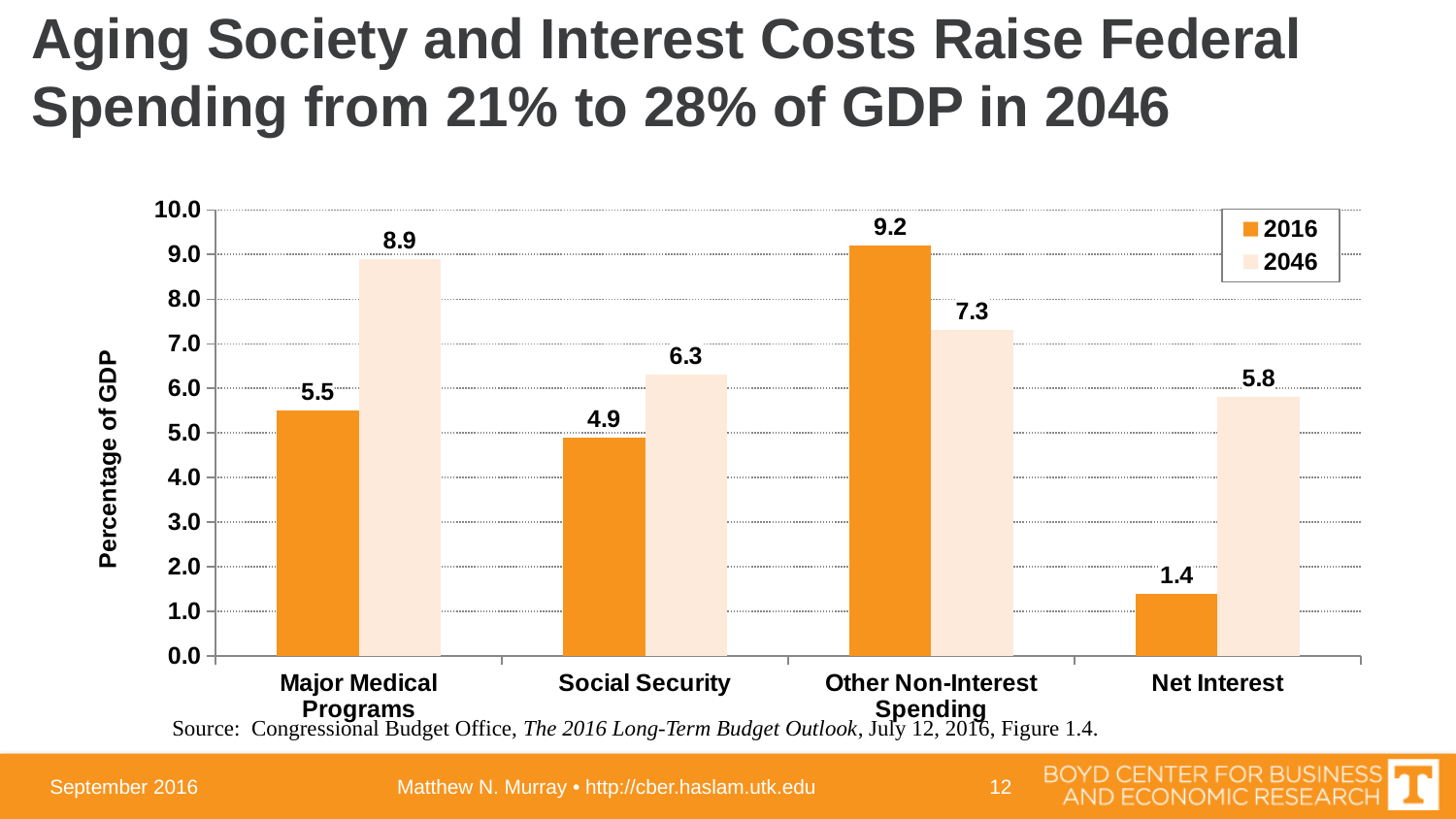
What is the 2046 value for Social Security? 6.3 Which category has the lowest 2016 value? Net Interest Which category has the highest 2016 value? Other Non-Interest Spending What is the 2046 value for Net Interest? 5.8 What is the 2016 value for Major Medical Programs? 5.5 How many categories are shown on the x axis? 4 Is the 2046 value for Net Interest greater or less than 5.0? greater Which is larger for Social Security, the 2016 value or the 2046 value? 2046 What kind of chart is shown on the slide? Bar chart What is the difference between the 2046 and 2016 values for Major Medical Programs? 3.4 How many series does the legend list? 2 What is the difference between the 2016 and 2046 values for Other Non-Interest Spending? 1.9